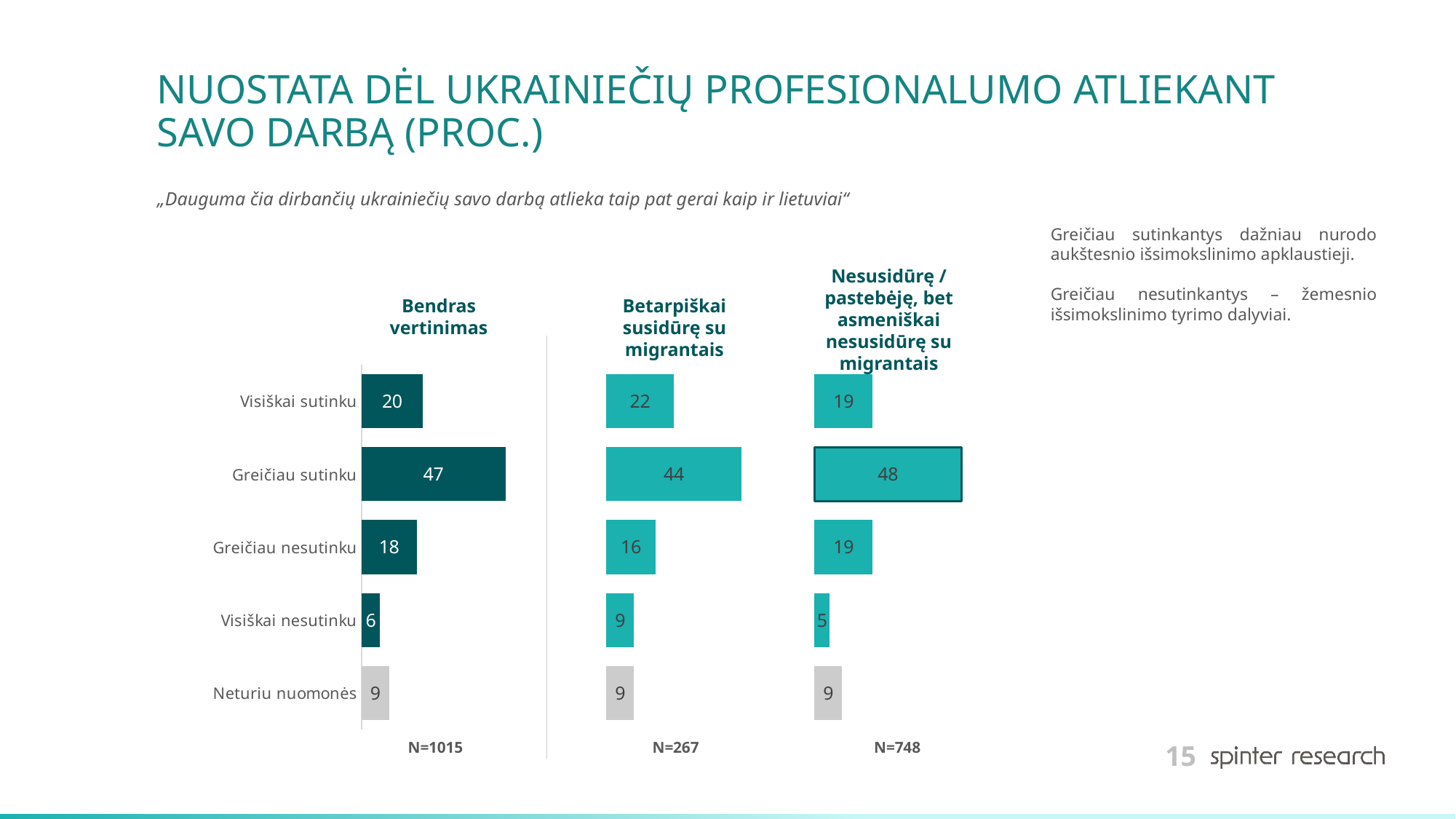
In the "Nesusidūrę / pastebėję, bet asmeniškai nesusidūrę su migrantais" chart, what is the value for "Neturiu nuomonės"? 9 In the "Bendras vertinimas" chart, which category has the highest value? Greičiau sutinku In the "Bendras vertinimas" chart, what is the value for "Greičiau sutinku"? 47 In the "Nesusidūrę / pastebėję, bet asmeniškai nesusidūrę su migrantais" chart, what is the value for "Visiškai nesutinku"? 5 In the "Betarpiškai susidūrę su migrantais" chart, what is the value for "Visiškai sutinku"? 22 How many categories does the "Bendras vertinimas" chart show? 5 In the "Betarpiškai susidūrę su migrantais" chart, what is the difference between "Visiškai sutinku" and "Greičiau nesutinku"? 6 What is the sample size (N) shown under the "Betarpiškai susidūrę su migrantais" chart? N=267 Which is larger: "Greičiau sutinku" in the "Betarpiškai susidūrę su migrantais" chart or "Greičiau sutinku" in the "Nesusidūrę / pastebėję, bet asmeniškai nesusidūrę su migrantais" chart? Nesusidūrę / pastebėję, bet asmeniškai nesusidūrę su migrantais In the "Betarpiškai susidūrę su migrantais" chart, which category has the lowest value? Visiškai nesutinku and Neturiu nuomonės (both 9) In the "Bendras vertinimas" chart, what is the difference between "Greičiau sutinku" and "Greičiau nesutinku"? 29 What type of chart is used on this slide? Bar chart